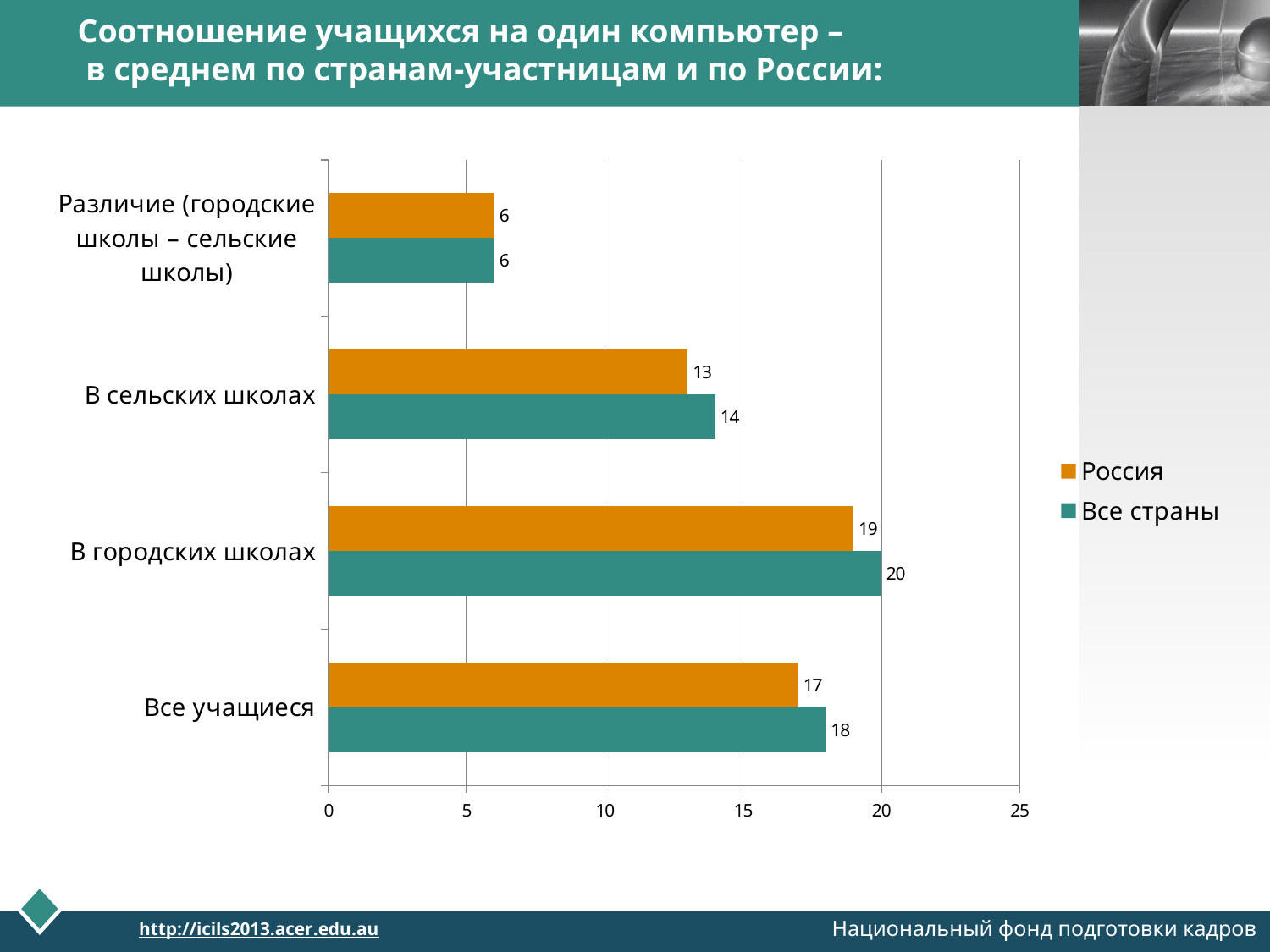
Which category has the lowest value for the Россия series? Различие (городские школы – сельские школы) What colour are the bars for the Россия series? Orange What is the difference between the Все страны and Россия values in the category В сельских школах? 1 What is the value for Россия in the category В сельских школах? 13 How many series does the legend list? 2 What is the value for Россия in the category Все учащиеся? 17 What is the value for Все страны in the category В городских школах? 20 In the category Все учащиеся, which series has the larger value, Россия or Все страны? Все страны How many categories are shown on the chart? 4 Which category has the highest value for the Все страны series? В городских школах What is the value for Все страны in the category Различие (городские школы – сельские школы)? 6 What kind of chart is shown on the slide? Bar chart